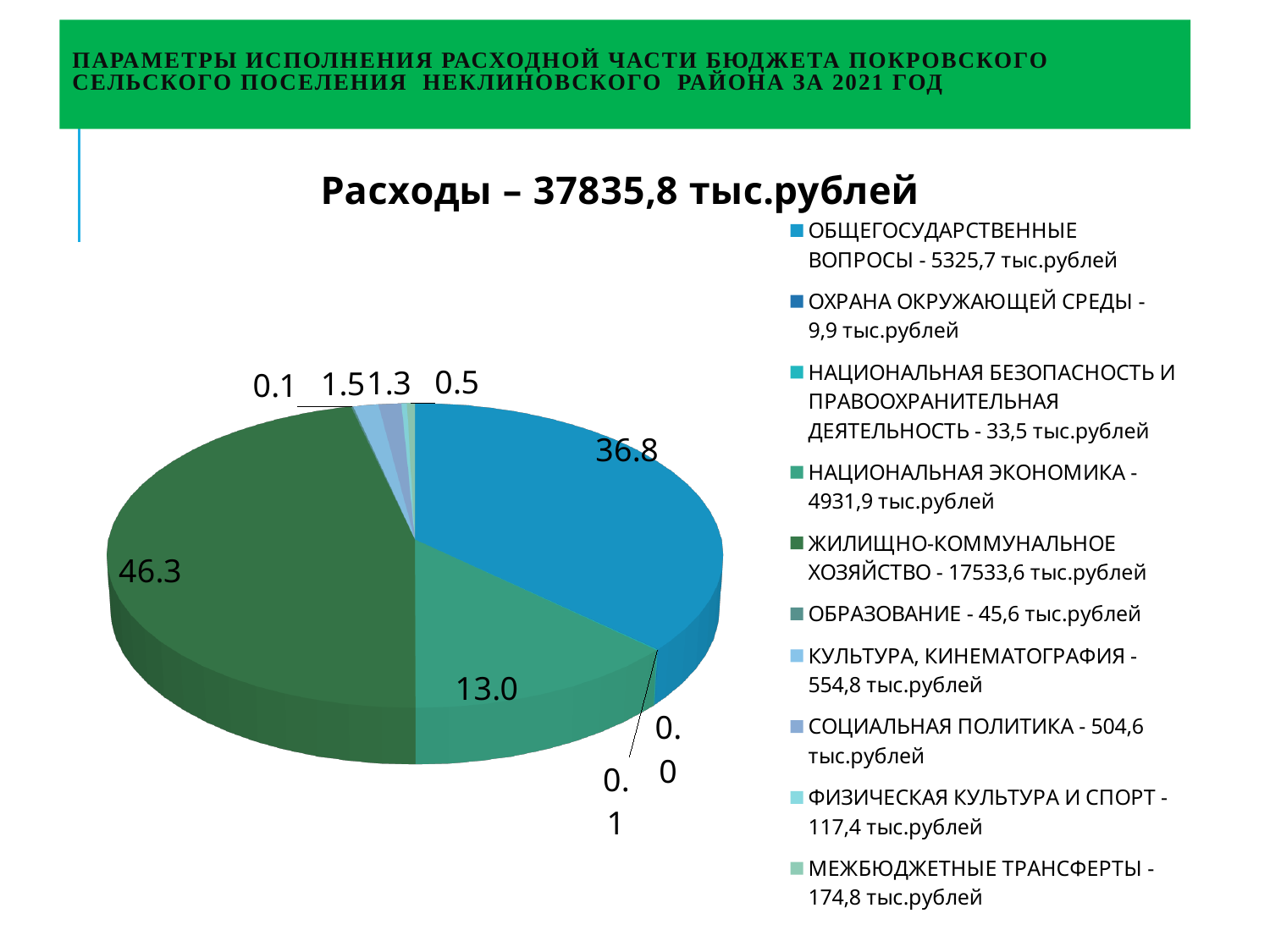
According to the legend, what is the amount for ЖИЛИЩНО-КОММУНАЛЬНОЕ ХОЗЯЙСТВО? 17533,6 тыс.рублей What total expenditure amount is stated in the chart title? 37835,8 тыс.рублей What type of chart is shown on the slide? pie chart How many categories does the legend of the pie chart list? 10 Which category has the largest share of the pie? ЖИЛИЩНО-КОММУНАЛЬНОЕ ХОЗЯЙСТВО According to the legend, what is the amount for ОХРАНА ОКРУЖАЮЩЕЙ СРЕДЫ? 9,9 тыс.рублей What share of the pie does ОБЩЕГОСУДАРСТВЕННЫЕ ВОПРОСЫ take? 36.8 What share of the pie does ЖИЛИЩНО-КОММУНАЛЬНОЕ ХОЗЯЙСТВО take? 46.3 Which is larger: the share for ОБЩЕГОСУДАРСТВЕННЫЕ ВОПРОСЫ or for НАЦИОНАЛЬНАЯ ЭКОНОМИКА? ОБЩЕГОСУДАРСТВЕННЫЕ ВОПРОСЫ What share of the pie does НАЦИОНАЛЬНАЯ ЭКОНОМИКА take? 13.0 By how much does the legend amount for ЖИЛИЩНО-КОММУНАЛЬНОЕ ХОЗЯЙСТВО exceed that for ОБЩЕГОСУДАРСТВЕННЫЕ ВОПРОСЫ? 12207,9 тыс.рублей According to the legend, what is the amount for КУЛЬТУРА, КИНЕМАТОГРАФИЯ? 554,8 тыс.рублей